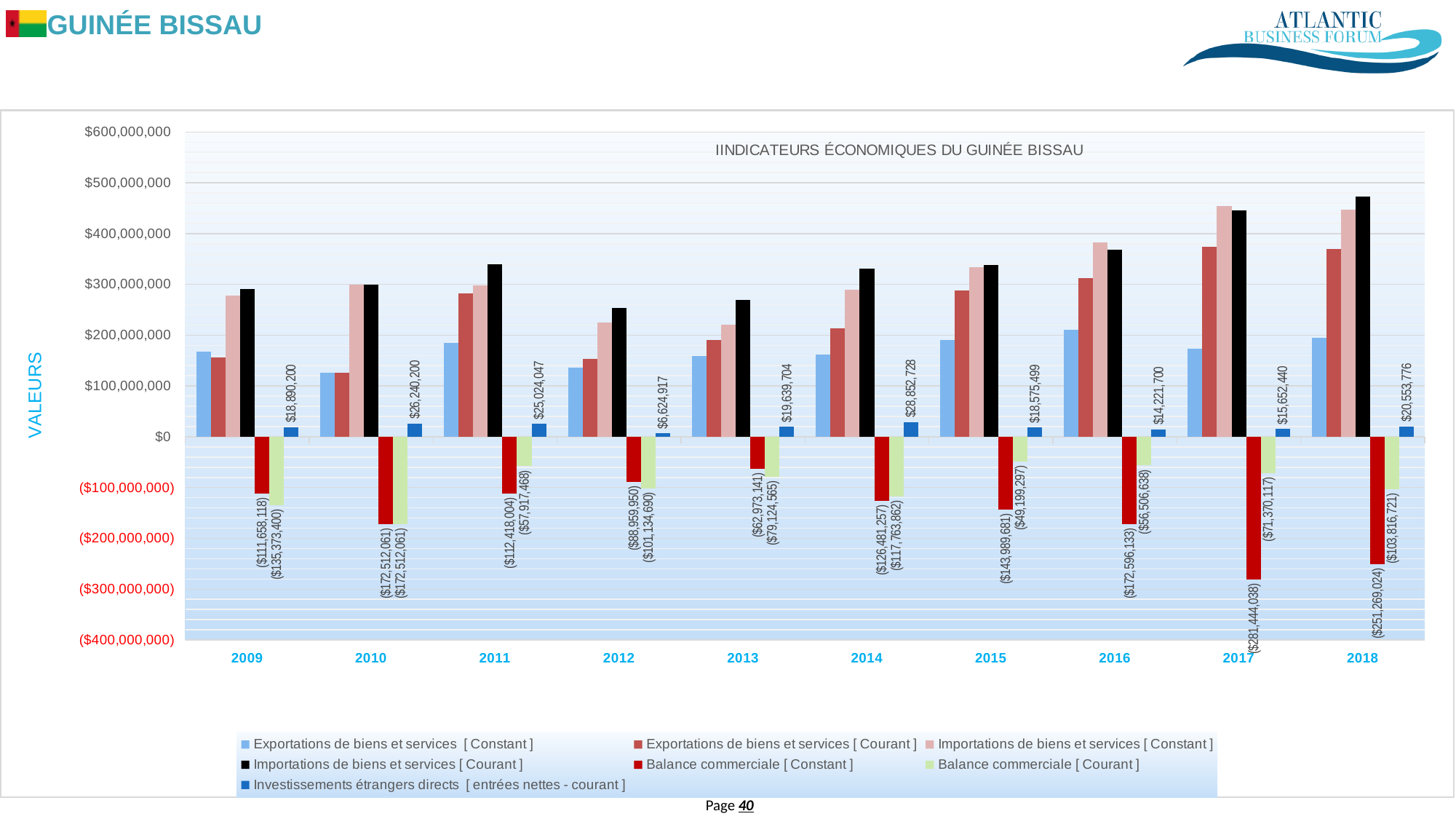
What is the value of Balance commerciale [Courant] in 2011? ($57,917,468) In which year is Investissements étrangers directs the highest? 2014 What is the difference between Investissements étrangers directs in 2014 and in 2012? $22,227,811 Which is larger, Investissements étrangers directs in 2010 or in 2011? 2010 How many series does the legend list? 7 What type of chart is shown on the slide? bar chart Is the value for Importations de biens et services [Courant] in 2018 greater or less than $400,000,000? greater How many years are shown on the x axis? 10 In which year is Investissements étrangers directs the lowest? 2012 What is the value of Investissements étrangers directs in 2014? $28,852,728 What is the title of the chart? IINDICATEURS ÉCONOMIQUES DU GUINÉE BISSAU What is the value of Balance commerciale [Constant] in 2017? ($281,444,038)